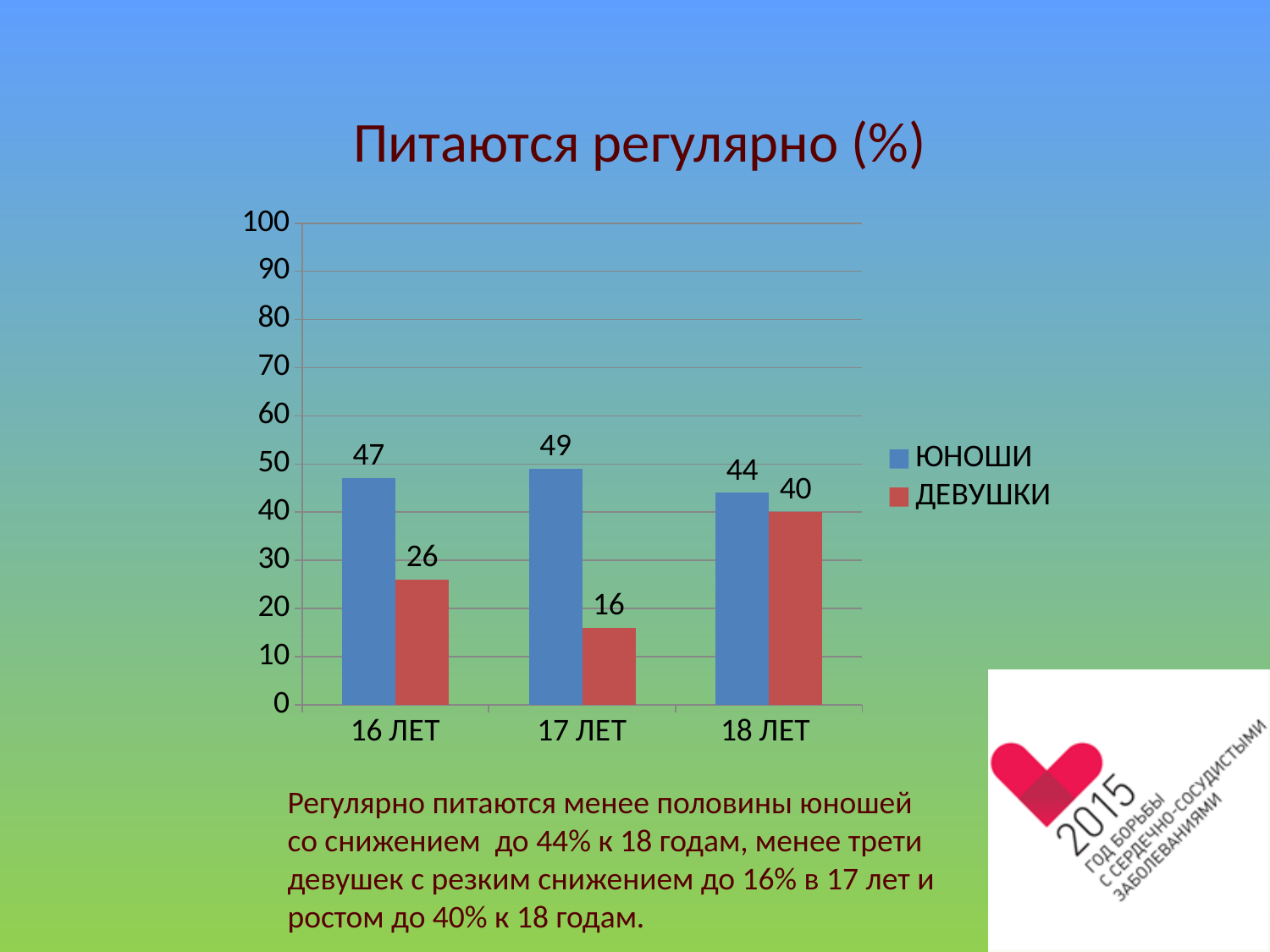
How many age categories are shown on the x axis? 3 How many series does the legend list? 2 Is the value for ДЕВУШКИ at 16 ЛЕТ greater or less than 30? less What is the difference between ЮНОШИ and ДЕВУШКИ at 17 ЛЕТ? 33 What is the title of the chart? Питаются регулярно (%) Which is larger at 18 ЛЕТ, ЮНОШИ or ДЕВУШКИ? ЮНОШИ At which age group is the value for ДЕВУШКИ lowest? 17 ЛЕТ What kind of chart is shown on the slide? bar chart What is the value for ДЕВУШКИ at 17 ЛЕТ? 16 At which age group is the value for ЮНОШИ highest? 17 ЛЕТ What is the value for ДЕВУШКИ at 18 ЛЕТ? 40 What is the value for ЮНОШИ at 16 ЛЕТ? 47